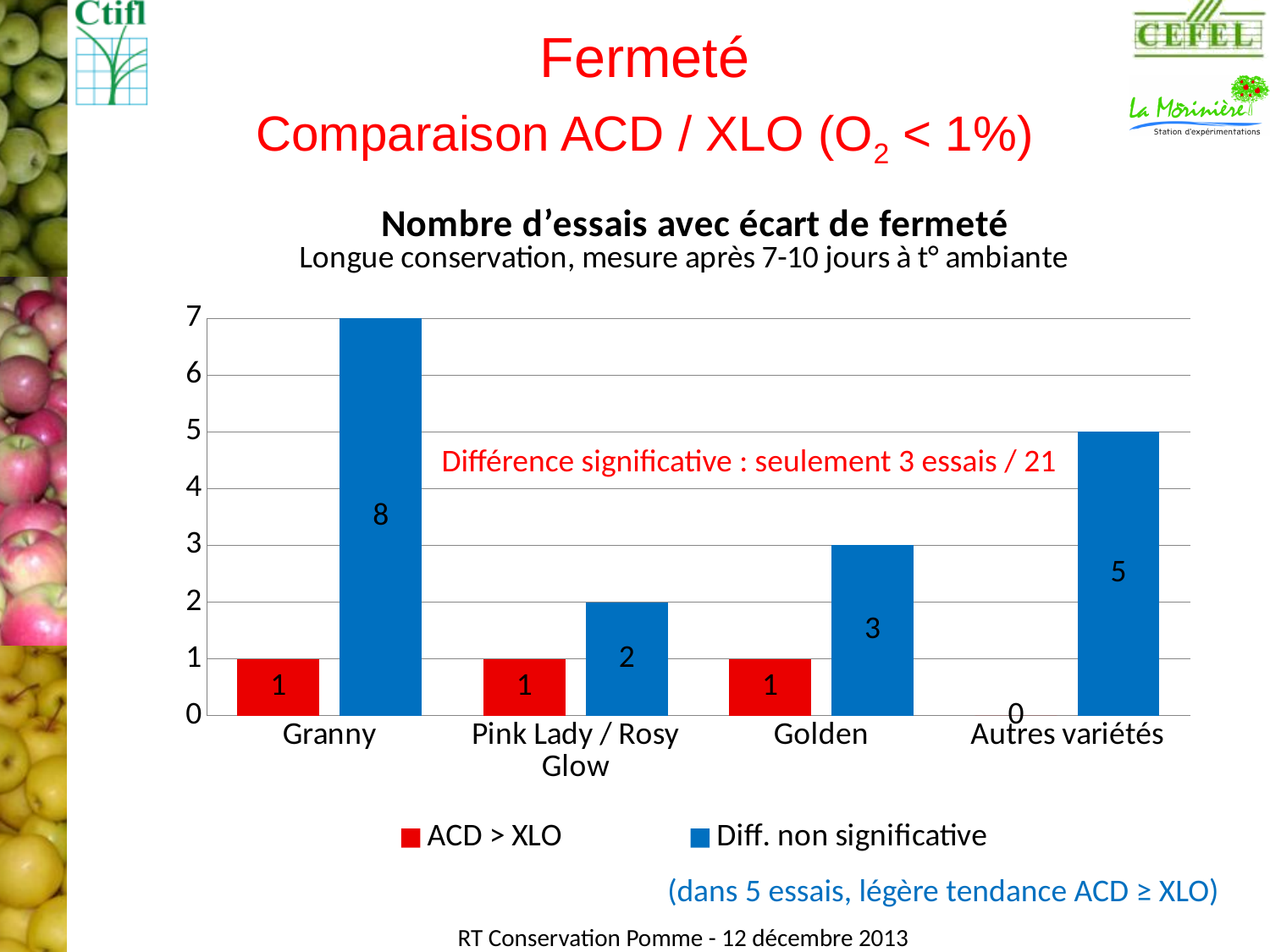
What is the value of 'ACD > XLO' for Autres variétés? 0 What is the value of 'Diff. non significative' for Golden? 3 Which category has the lowest 'Diff. non significative' value? Pink Lady / Rosy Glow Is the 'Diff. non significative' value for Granny greater or less than 5? greater What is the title of the chart? Nombre d'essais avec écart de fermeté How many series does the legend list? 2 What is the difference between the 'Diff. non significative' values for Autres variétés and Golden? 2 What kind of chart is shown on the slide? bar chart What is the value of 'Diff. non significative' for Autres variétés? 5 What is the value of 'Diff. non significative' for Pink Lady / Rosy Glow? 2 How many categories are shown on the x axis? 4 Which category has the highest 'Diff. non significative' value? Granny